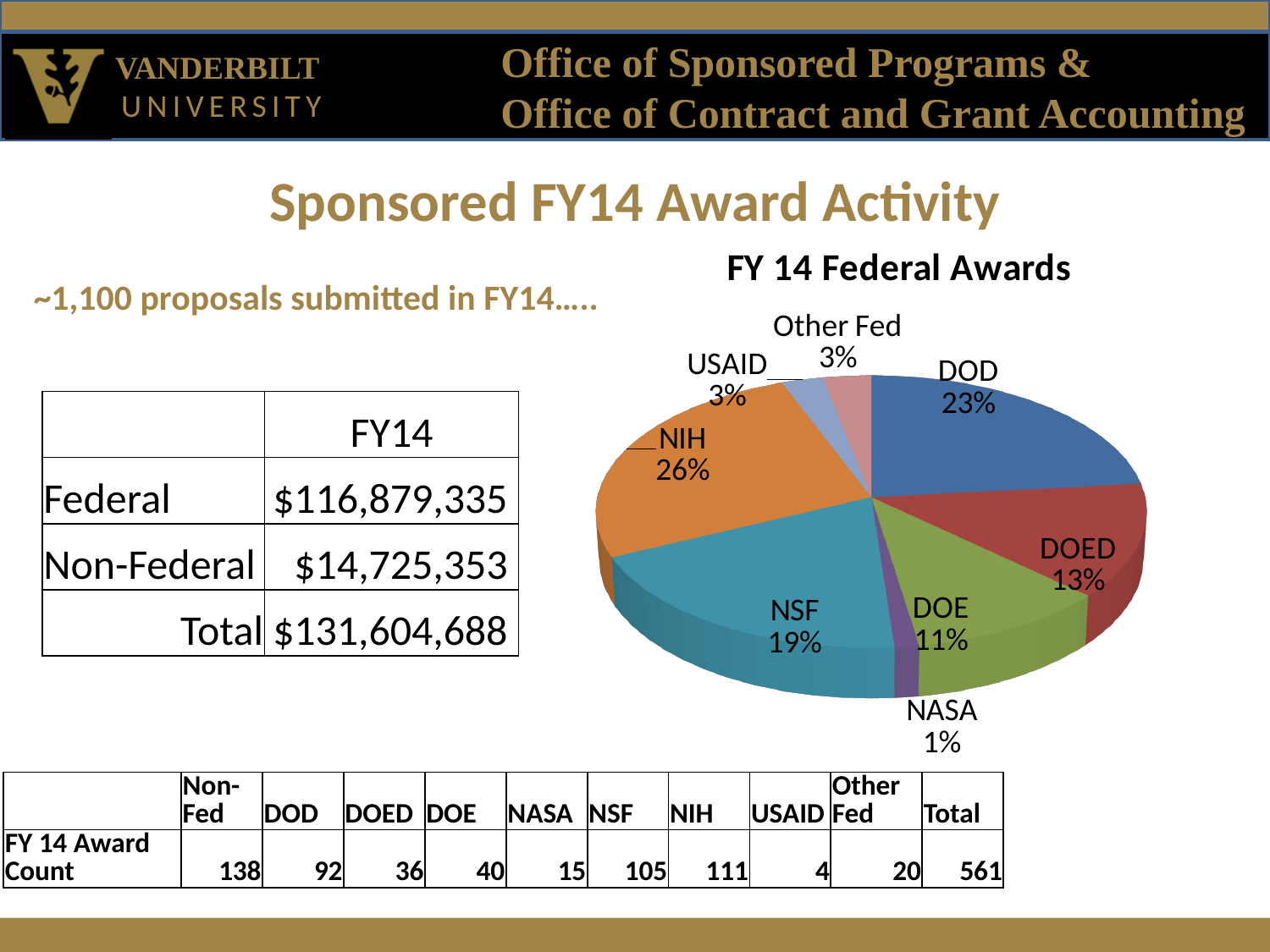
What kind of chart is shown under the title "FY 14 Federal Awards"? pie chart Which agency has the smallest slice in the FY 14 Federal Awards pie chart? NASA In the FY 14 Federal Awards pie chart, which is larger, the DOD slice or the NSF slice? DOD In the FY 14 Federal Awards pie chart, what share does NIH have? 26% In the FY 14 Federal Awards pie chart, what share does DOED have? 13% In the FY 14 Federal Awards pie chart, what share does DOD have? 23% In the FY 14 Federal Awards pie chart, what share does NASA have? 1% In the FY 14 Federal Awards pie chart, what share does NSF have? 19% In the FY 14 Federal Awards pie chart, how many percentage points larger is the NIH share than the DOE share? 15 Which agency has the largest slice in the FY 14 Federal Awards pie chart? NIH In the FY 14 Federal Awards pie chart, which two agencies each have a 3% share? USAID and Other Fed How many slices does the FY 14 Federal Awards pie chart have? 8